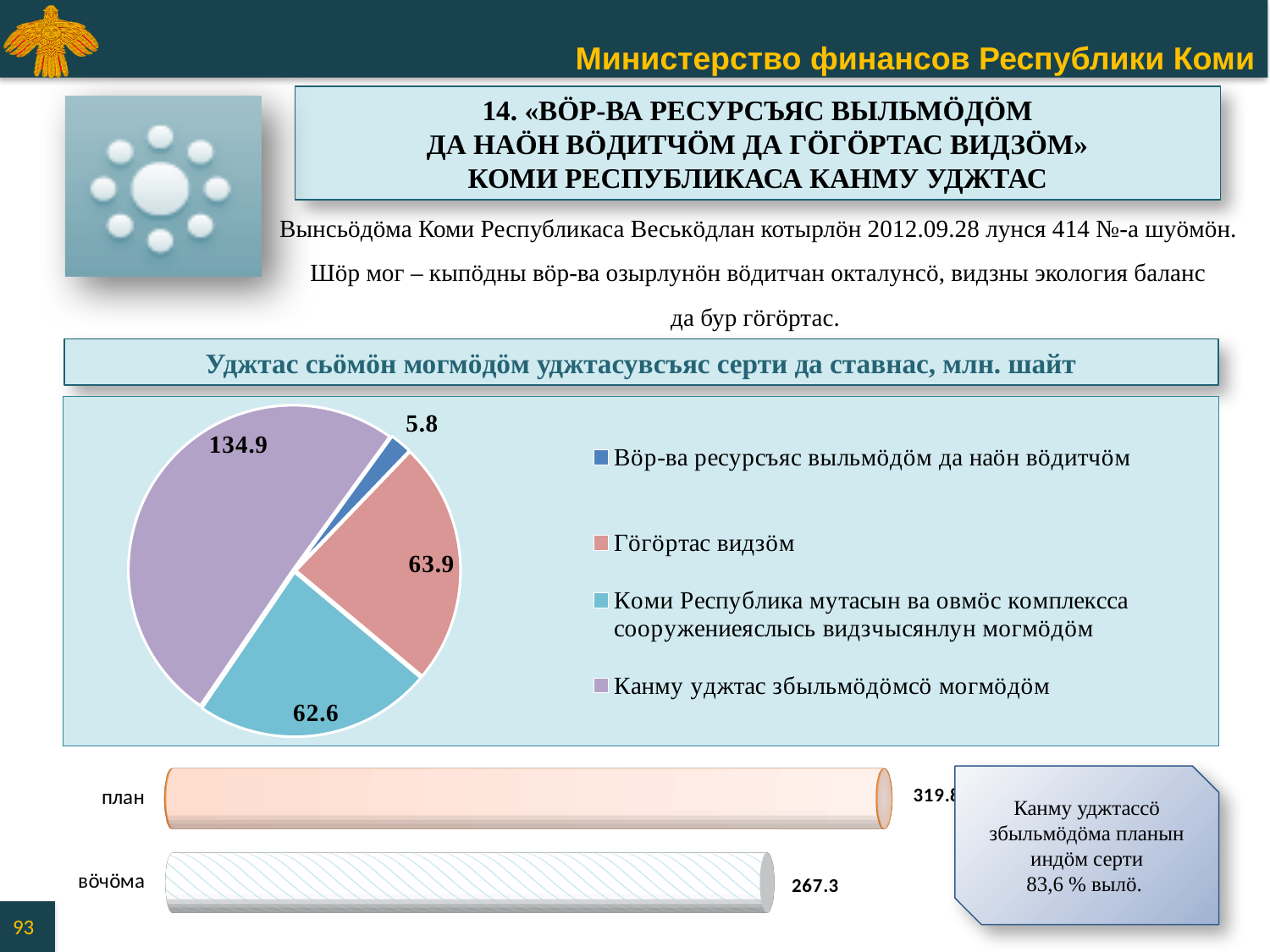
In the pie chart, what value is shown for the slice «Вöр-ва ресурсъяс вылльмöдöм да наöн вöдитчöм»? 5.8 In the pie chart, which category has the largest slice? Канму уджтас збыльмöдöмсö могмöдöм In the pie chart, what value is shown for the slice «Коми Республика мутасын ва овмöс комплексса сооружениеяслысь видзчысянлун могмöдöм»? 62.6 In the pie chart, what value is shown for the slice labelled «Канму уджтас збыльмöдöмсö могмöдöм»? 134.9 How many entries does the legend of the pie chart list? 4 In the bar chart at the bottom of the slide, what value is shown for «вöчöма»? 267.3 In the pie chart, what is the difference between the largest slice (134.9) and the slice «Гöгöртас видзöм» (63.9)? 71.0 In the pie chart, what value is shown for the slice «Гöгöртас видзöм»? 63.9 In the pie chart, which category has the smallest slice? Вöр-ва ресурсъяс вылльмöдöм да наöн вöдитчöм In the pie chart, which is larger: the slice «Гöгöртас видзöм» or the slice «Коми Республика мутасын ва овмöс комплексса сооружениеяслысь видзчысянлун могмöдöм»? Гöгöртас видзöм In the bar chart at the bottom of the slide, which bar is longer: «план» or «вöчöма»? план How many slices does the pie chart have? 4